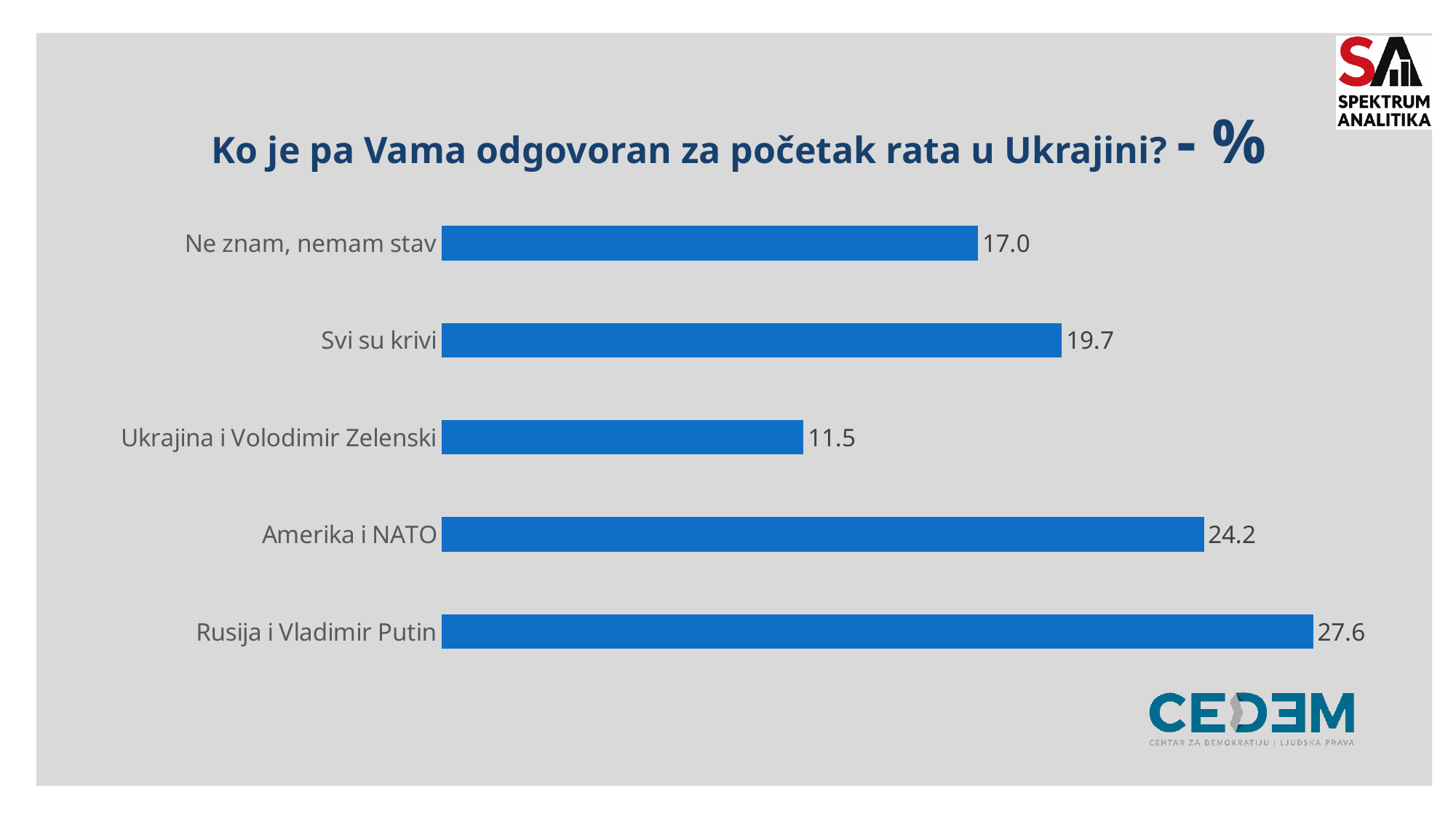
What is the title of the chart? Ko je pa Vama odgovoran za početak rata u Ukrajini? - % Which category has the highest value? Rusija i Vladimir Putin What kind of chart is shown on the slide? Bar chart What is the value for Amerika i NATO? 24.2 What is the value for Rusija i Vladimir Putin? 27.6 Which is larger, the value for Svi su krivi or the value for Ne znam, nemam stav? Svi su krivi What is the difference between the values for Rusija i Vladimir Putin and Amerika i NATO? 3.4 Which category has the lowest value? Ukrajina i Volodimir Zelenski What is the value for Ukrajina i Volodimir Zelenski? 11.5 What is the value for Ne znam, nemam stav? 17.0 How many categories are shown in the chart? 5 What is the value for Svi su krivi? 19.7